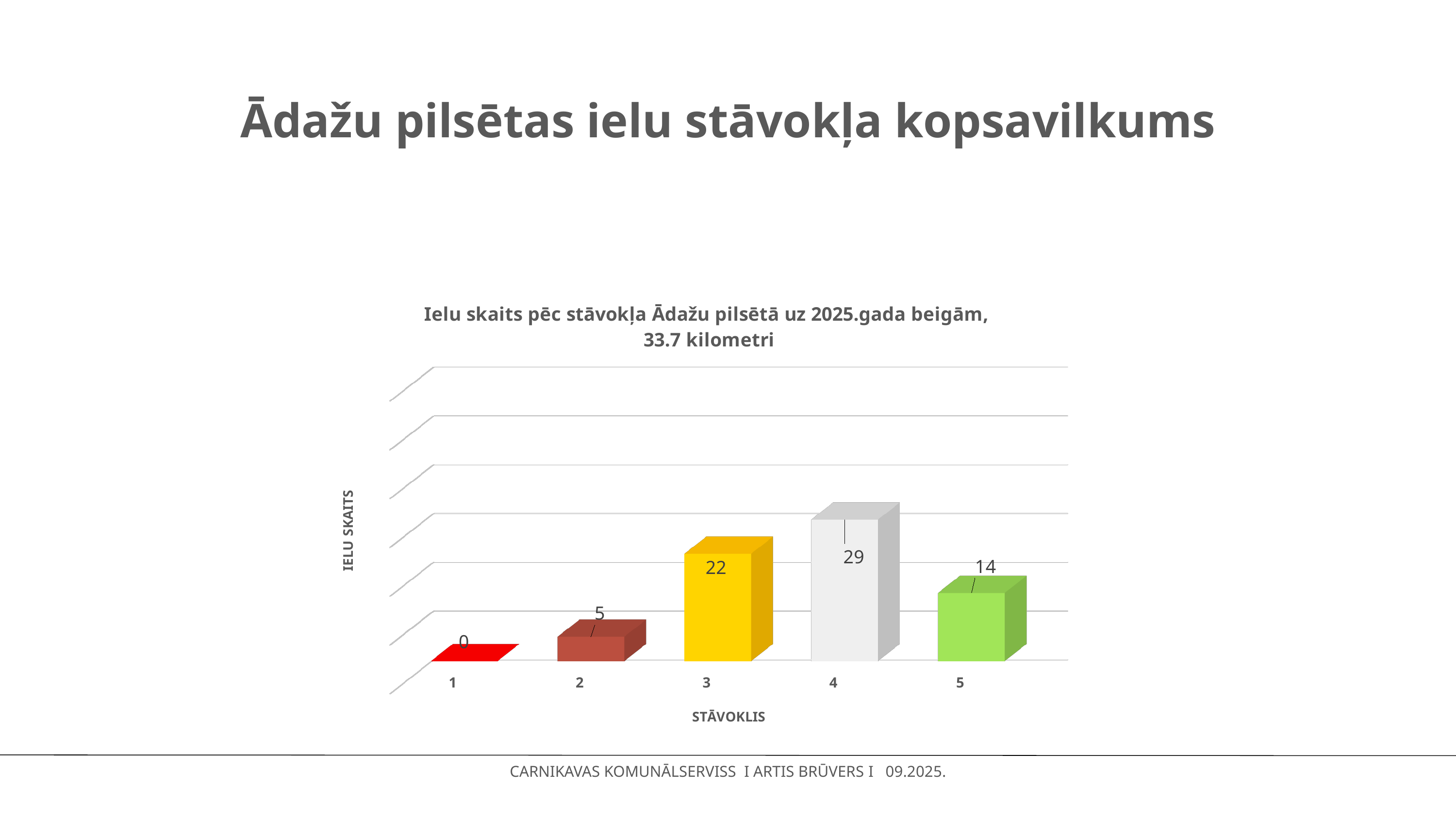
What is the value for condition category 1? 0 Which is larger, the value for category 3 or the value for category 5? category 3 What is the value for condition category 5? 14 What is the value for condition category 3? 22 Which condition category has the highest number of streets? 4 What is the value for condition category 2? 5 What is the label of the x axis of the chart? STĀVOKLIS Which condition category has the lowest number of streets? 1 What is the difference between the values for category 4 and category 3? 7 What kind of chart is shown on the slide? bar chart How many condition categories are shown on the x axis? 5 What is the value for condition category 4? 29